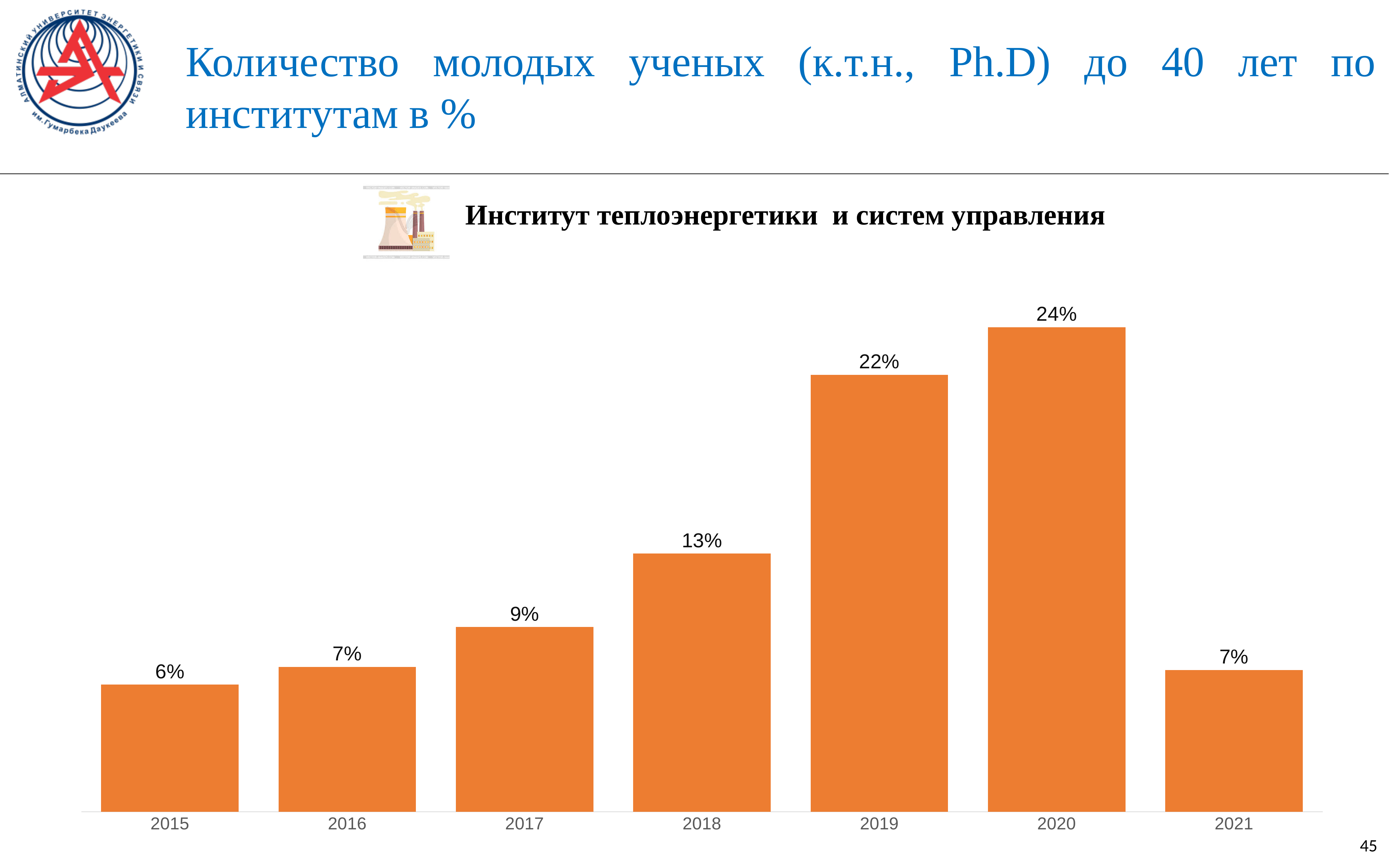
What is the value for 2015? 6% Which is larger, the value for 2019 or the value for 2021? 2019 Do the values rise or fall from 2015 to 2020? rise What is the difference between the values for 2020 and 2019? 2% Which institute does the chart refer to? Институт теплоэнергетики и систем управления What is the value for 2018? 13% What is the difference between the values for 2018 and 2017? 4% Which year has the highest value? 2020 What kind of chart is shown on the slide? bar chart Which year has the lowest value? 2015 How many years are shown on the x axis? 7 What is the value for 2020? 24%